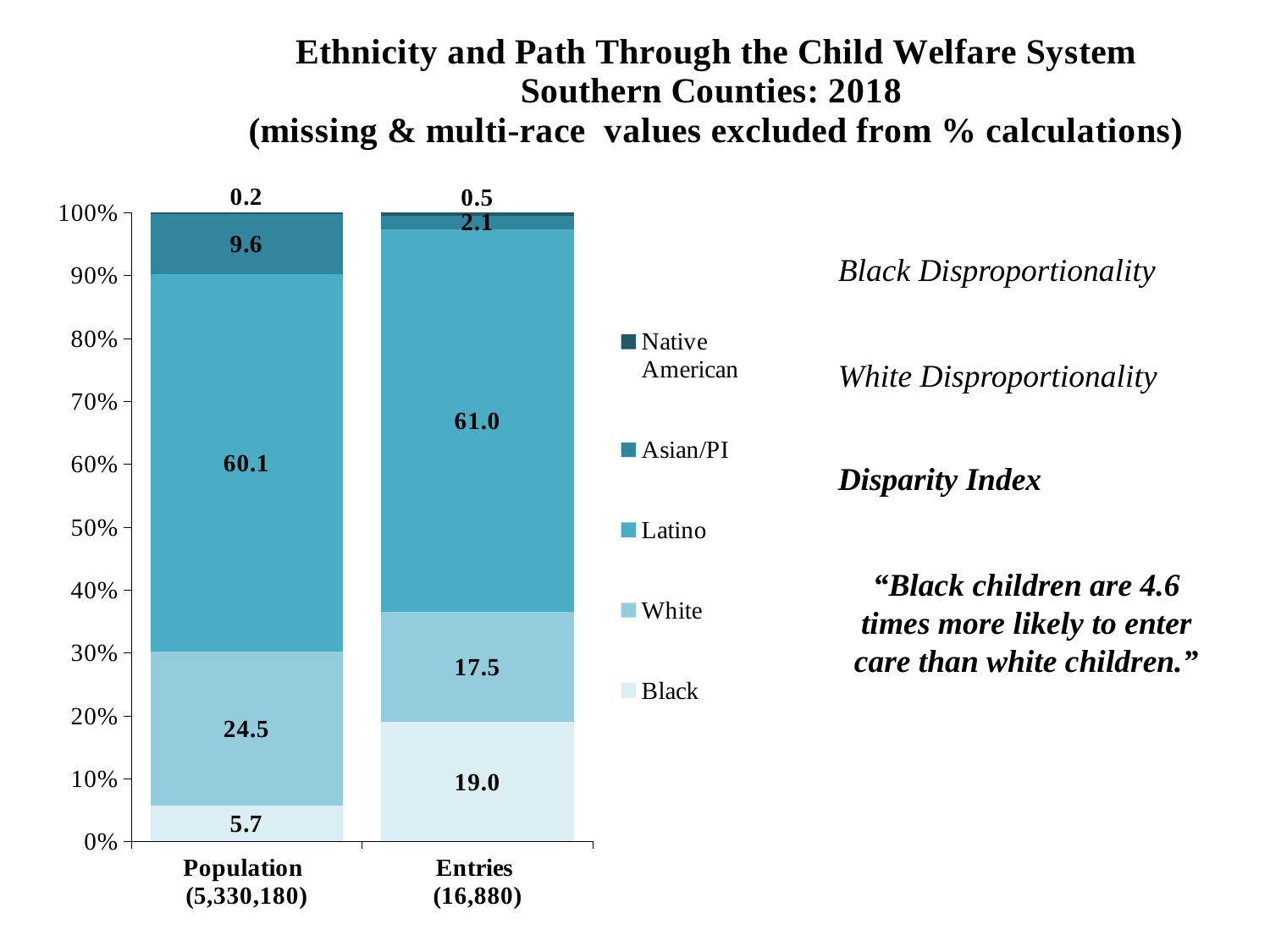
What is the difference between the White share for Population and the White share for Entries? 7.0 Which ethnicity has the smallest share in the Entries bar? Native American Is the Black share larger for Population or for Entries? Entries What is the Native American value for Entries? 0.5 What is the Black share of the Population bar? 5.7 What is the Latino value for Entries? 61.0 What is the Black share of the Entries bar? 19.0 Which ethnicity has the largest share in the Population bar? Latino How many bars (categories) are plotted on the x axis? 2 What kind of chart is shown on the slide? Stacked bar chart How many series does the legend list? 5 What is the Asian/PI value for Population? 9.6